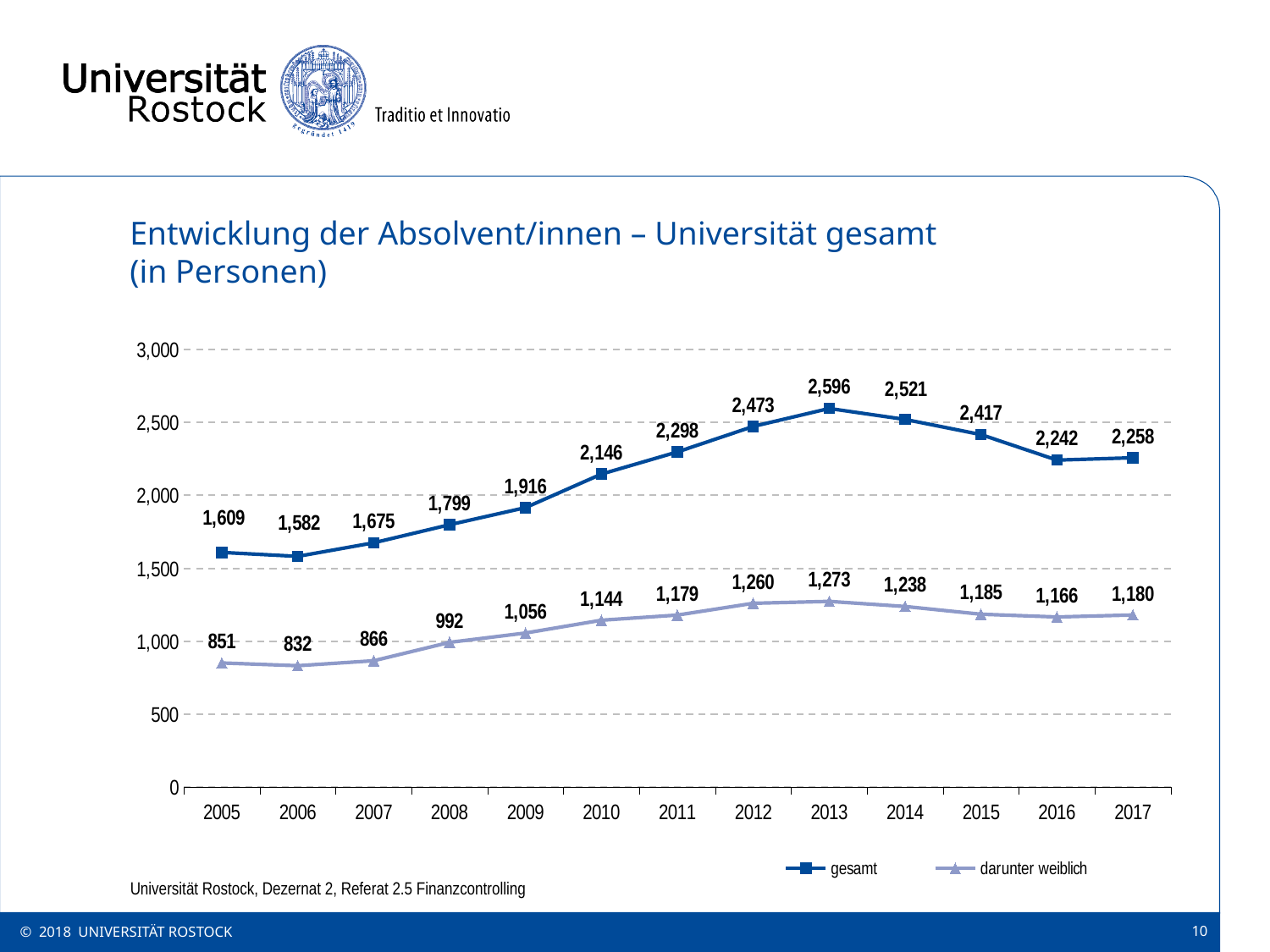
What kind of chart is shown on the slide? line chart What is the value of the 'gesamt' series in 2013? 2,596 In which year is the 'darunter weiblich' series lowest? 2006 What is the value of the 'darunter weiblich' series in 2008? 992 In which year does the 'gesamt' series reach its highest value? 2013 Is the 'gesamt' value for 2010 greater or less than 2,000? greater Does the 'gesamt' series rise or fall from 2013 to 2016? fall What is the difference between the 'gesamt' and 'darunter weiblich' values in 2017? 1,078 How many series does the legend list? 2 Which is larger: the 'gesamt' value in 2014 or in 2015? 2014 How many years are shown on the x axis? 13 What is the title of the chart? Entwicklung der Absolvent/innen – Universität gesamt (in Personen)